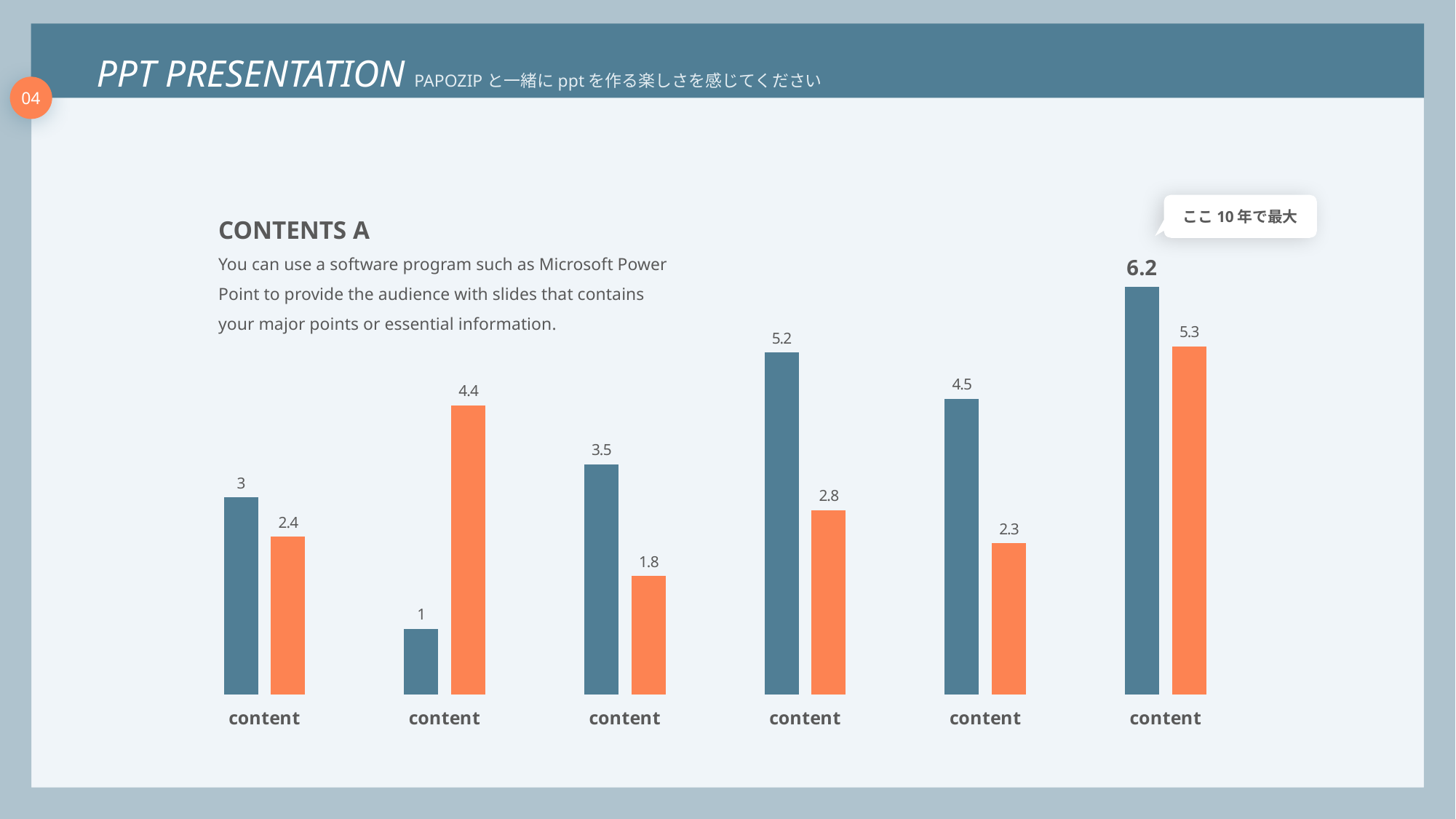
Which group has the lowest orange bar? the third group from the left, 1.8 In the third group from the left, which bar is larger, the blue or the orange? blue What kind of chart is shown on the slide? bar chart Which group has the highest blue bar? the rightmost (sixth) group, 6.2 What is the value of the blue bar in the fourth group from the left? 5.2 What is the value of the orange bar in the second group from the left? 4.4 What is the value of the blue bar in the rightmost group? 6.2 In the rightmost group, what is the difference between the blue bar and the orange bar? 0.9 Which group has the lowest blue bar? the second group from the left, 1 What is the highest orange bar value? 5.3 What does the callout above the tallest bar say? ここ 10 年で最大 How many category groups are plotted along the x axis? 6